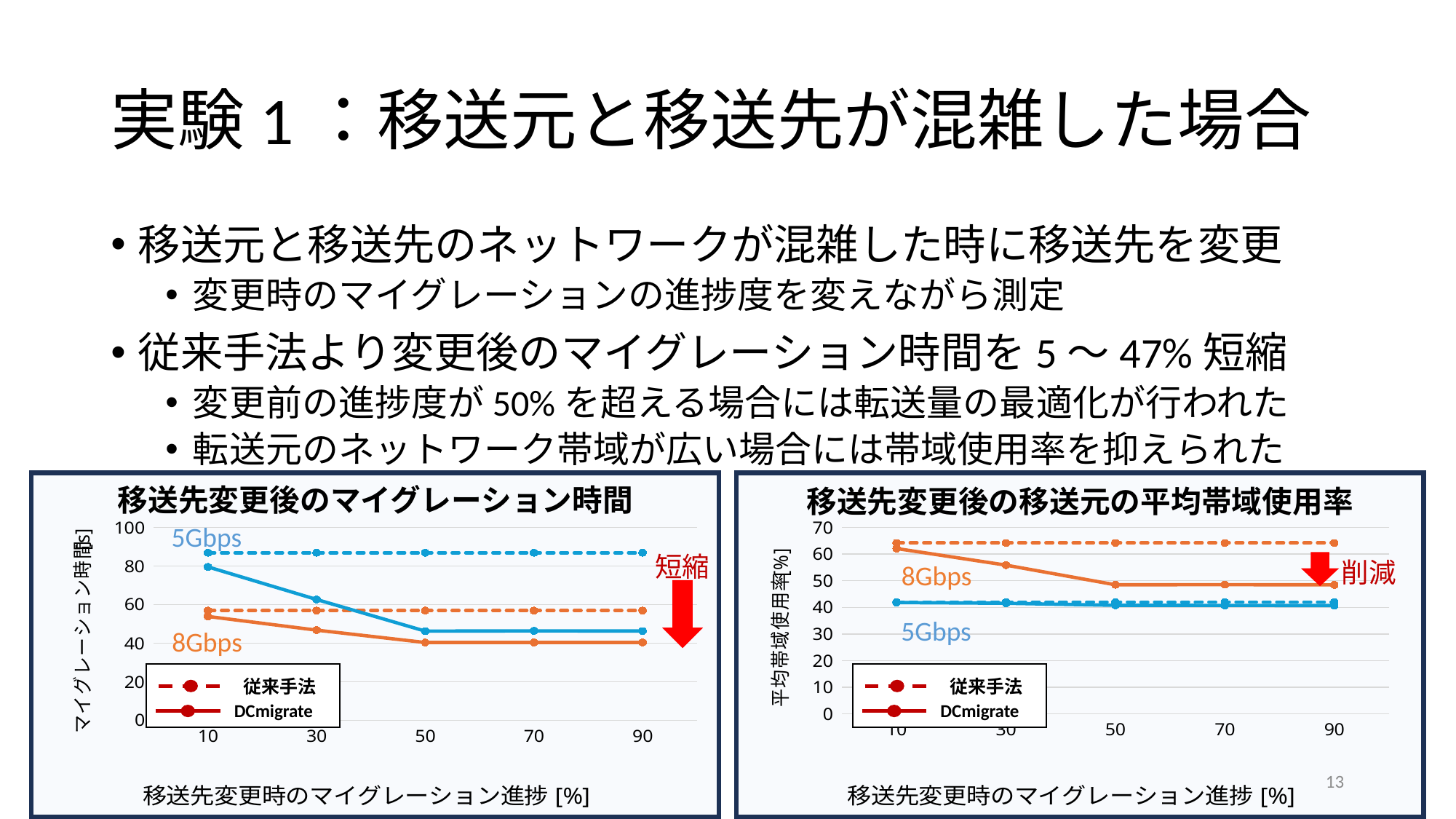
In the left chart (移送先変更後のマイグレーション時間), is the 従来手法 value for 5Gbps at progress 90 greater or less than 80? greater In the right chart (移送先変更後の移送元の平均帯域使用率), is the 従来手法 value for 8Gbps at progress 50 greater or less than 60? greater In the left chart (移送先変更後のマイグレーション時間), how many x-axis points (progress values) are plotted for each line? 5 What kind of chart is the right chart titled 移送先変更後の移送元の平均帯域使用率? line chart In the left chart (移送先変更後のマイグレーション時間), is the DCmigrate value for 8Gbps at progress 90 greater or less than 60? less What is the x-axis title of the left chart (移送先変更後のマイグレーション時間)? 移送先変更時のマイグレーション進捗 [%] What kind of chart is the left chart titled 移送先変更後のマイグレーション時間? line chart In the left chart (移送先変更後のマイグレーション時間), how many entries does the legend list? 2 In the right chart (移送先変更後の移送元の平均帯域使用率), does the DCmigrate line for 8Gbps rise or fall from progress 10 to progress 50? fall In the left chart (移送先変更後のマイグレーション時間), does the DCmigrate line for 5Gbps rise or fall from progress 10 to progress 50? fall